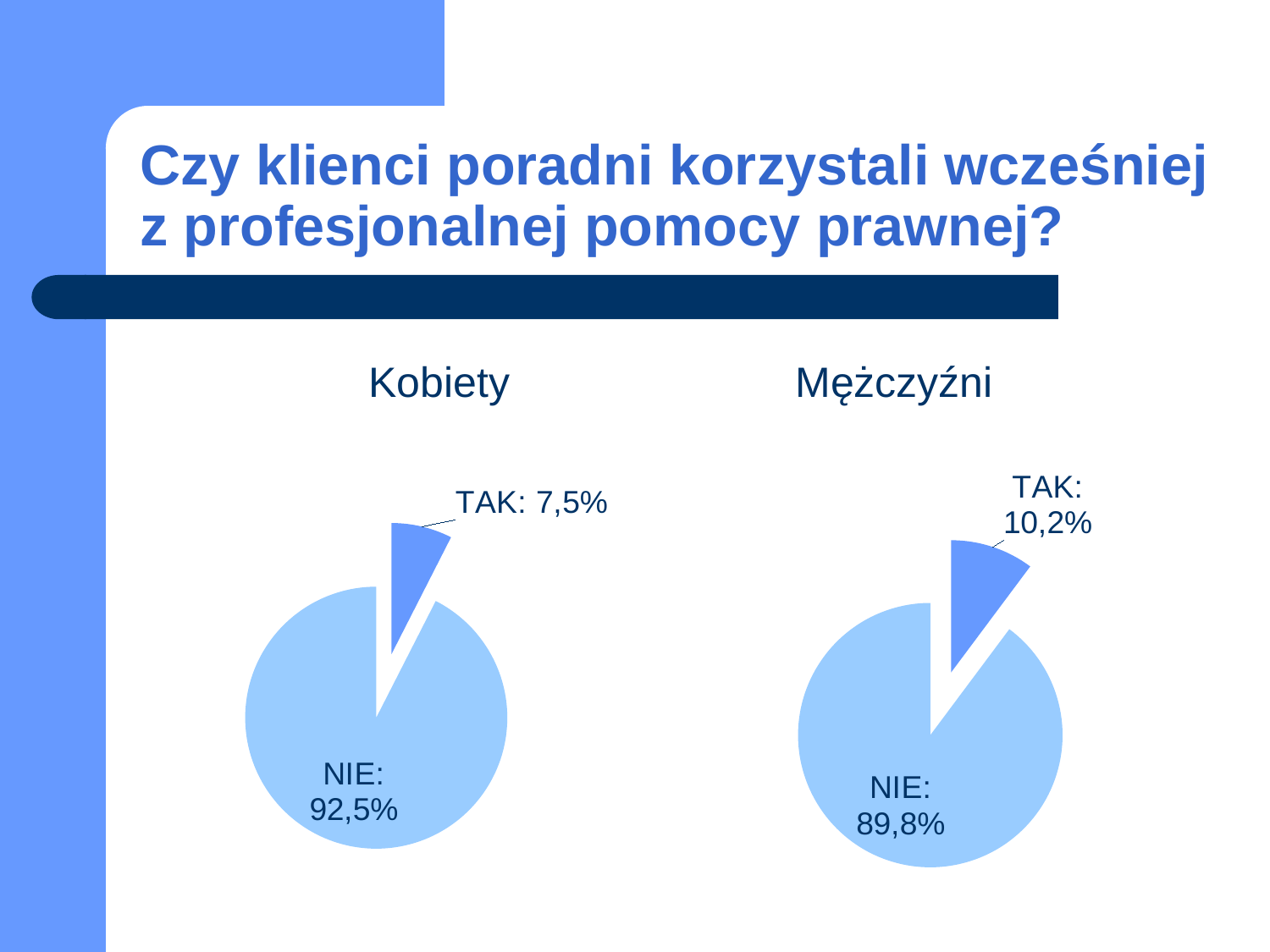
In the Mężczyźni pie chart, which slice is the smallest? TAK In the Mężczyźni pie chart, what is the value for NIE? 89,8% What share of the Mężczyźni pie does the NIE slice represent? 89,8% In the Mężczyźni pie chart, what is the value for TAK? 10,2% Which is larger: the TAK value in the Kobiety chart or the TAK value in the Mężczyźni chart? Mężczyźni In the Kobiety pie chart, which slice is the largest? NIE What kind of chart is the Kobiety chart? Pie chart How many pie charts are shown on the slide? 2 In the Kobiety pie chart, what is the value for TAK? 7,5% In the Kobiety pie chart, what is the value for NIE? 92,5% How many slices does the Mężczyźni pie chart have? 2 What is the difference between the NIE and TAK values in the Kobiety pie chart? 85%